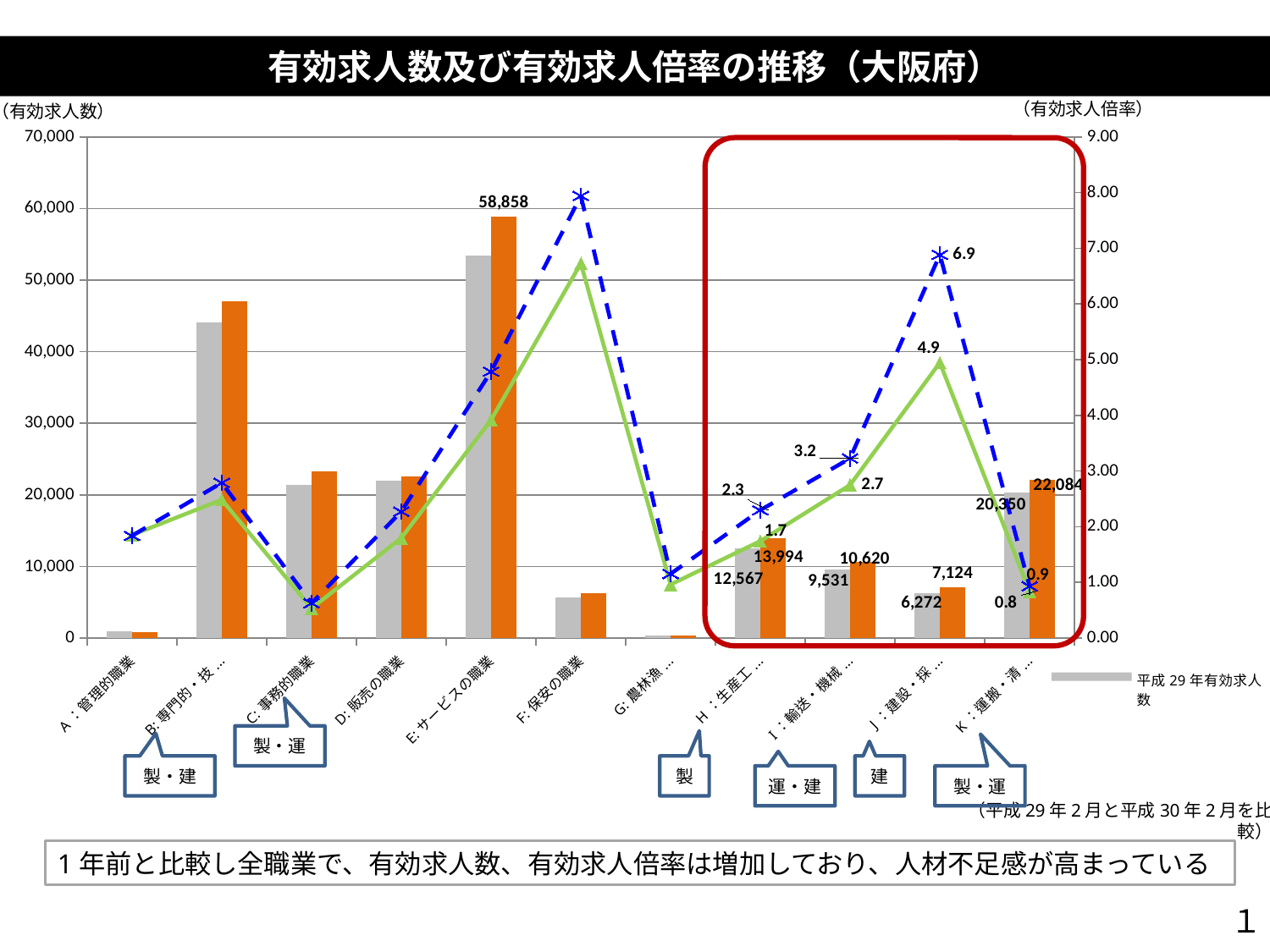
At J: 建設・採…, which line has the higher 有効求人倍率 value, the blue dashed line (6.9) or the green solid line (4.9)? The blue dashed line (6.9) What is the labeled value of the orange bar for I: 輸送・機械…? 10,620 What is the difference between the orange bar (13,994) and the gray bar (12,567) for H: 生産工…? 1,427 What is the difference between the orange bar (22,084) and the gray bar (20,350) for K: 運搬・清…? 1,734 What is the labeled value of the orange bar for E: サービスの職業? 58,858 Which occupation category has the lowest bars for 有効求人数? G: 農林漁… Which occupation category has the highest bars for 有効求人数? E: サービスの職業 What kind of chart is this? Combined bar and line chart How many occupation categories are shown on the x axis? 11 Is the orange bar for B: 専門的・技… greater or less than 40,000? greater What is the 平成29年有効求人数 (gray bar) value for K: 運搬・清…? 20,350 What is the labeled value of the green solid line at J: 建設・採…? 4.9